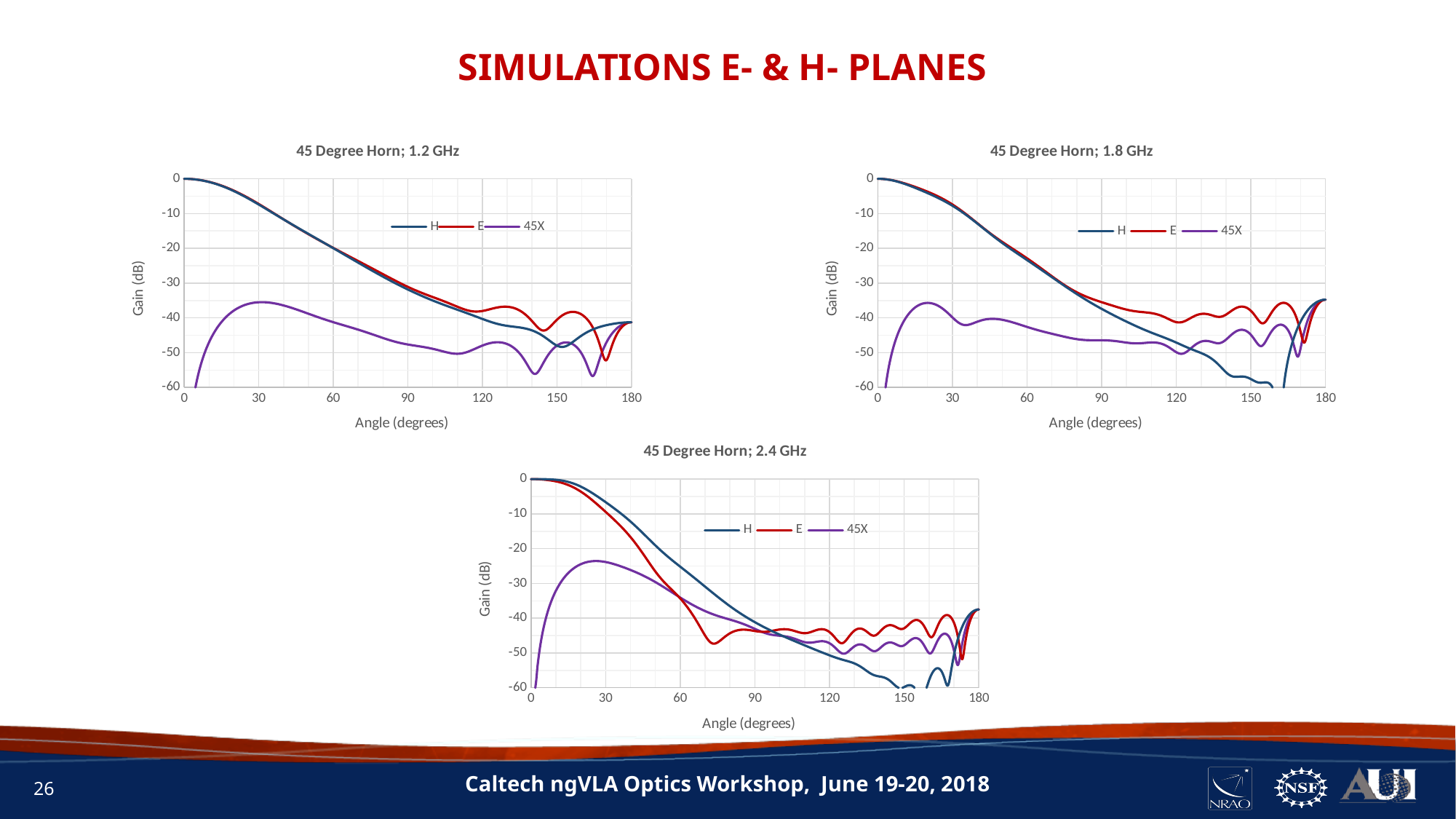
What is the y-axis label of the "45 Degree Horn; 1.2 GHz" chart? Gain (dB) What are the legend entries in the "45 Degree Horn; 2.4 GHz" chart? H, E, 45X In the "45 Degree Horn; 1.2 GHz" chart, is the value for E at 90 degrees greater or less than -40? greater How many series does the legend of the "45 Degree Horn; 1.8 GHz" chart list? 3 In the "45 Degree Horn; 1.2 GHz" chart, is the value for 45X at 30 degrees greater or less than -30? less How many charts are shown on the slide? 3 In the "45 Degree Horn; 1.2 GHz" chart, which series has the larger value at 30 degrees, H or 45X? H In the "45 Degree Horn; 1.8 GHz" chart, does the H series rise or fall as the angle goes from 0 to 90 degrees? fall What kind of chart is the "45 Degree Horn; 1.2 GHz" chart? line chart In the "45 Degree Horn; 2.4 GHz" chart, is the value for 45X at 30 degrees greater or less than -30? greater In the "45 Degree Horn; 2.4 GHz" chart, which series has the larger value at 60 degrees, H or E? H